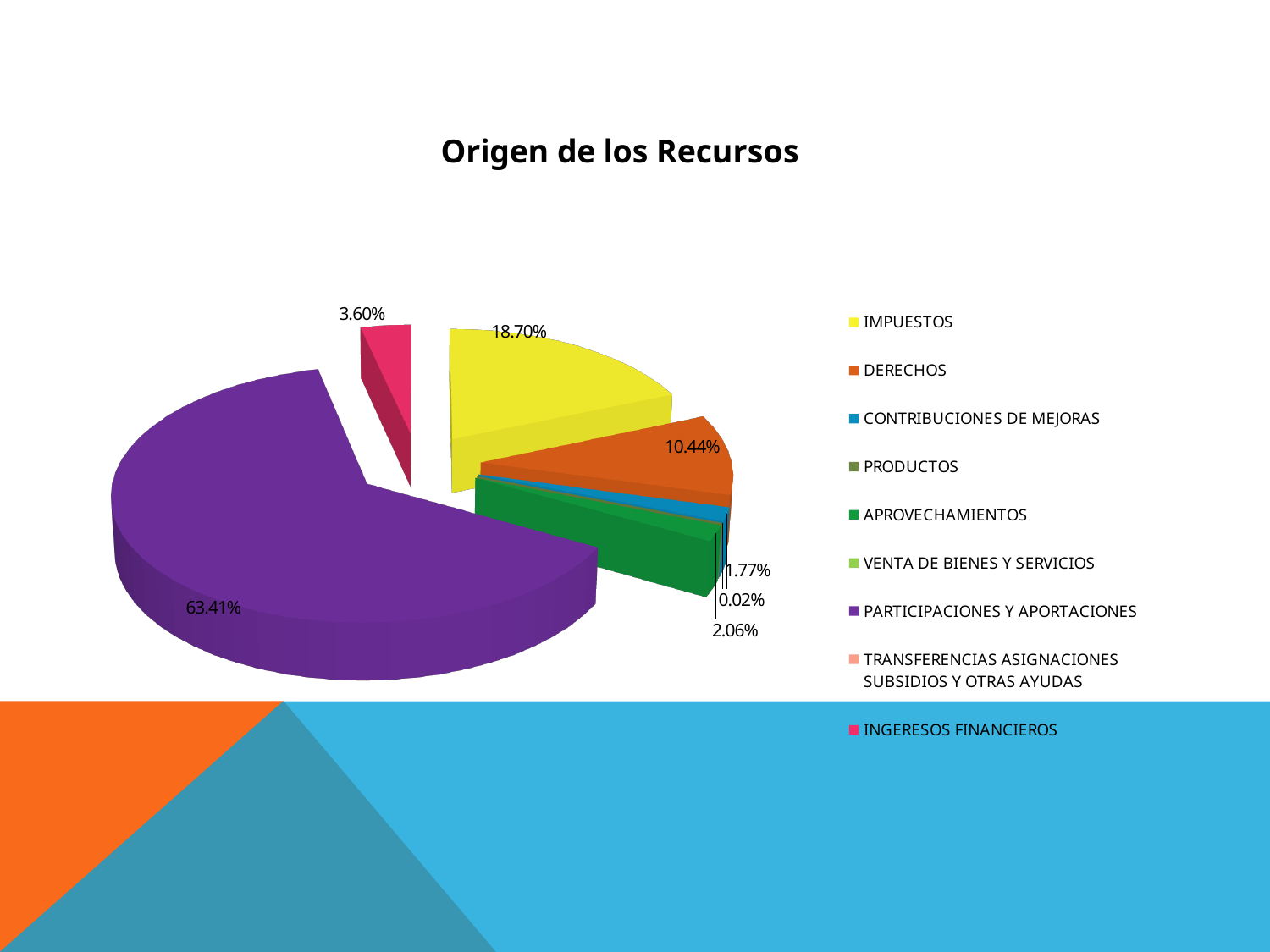
What is the title of the chart? Origen de los Recursos What percentage is shown for IMPUESTOS? 18.70% Which is larger, the share for IMPUESTOS or the share for DERECHOS? IMPUESTOS What percentage is shown for PARTICIPACIONES Y APORTACIONES? 63.41% Which category has the largest share of the pie? PARTICIPACIONES Y APORTACIONES What percentage is shown for INGERESOS FINANCIEROS? 3.60% What is the difference in percentage points between PARTICIPACIONES Y APORTACIONES and IMPUESTOS? 44.71 What colour is the slice for PARTICIPACIONES Y APORTACIONES? Purple What percentage is shown for DERECHOS? 10.44% How many categories does the legend list? 9 What percentage is shown for APROVECHAMIENTOS? 2.06% What type of chart is shown on the slide? Pie chart